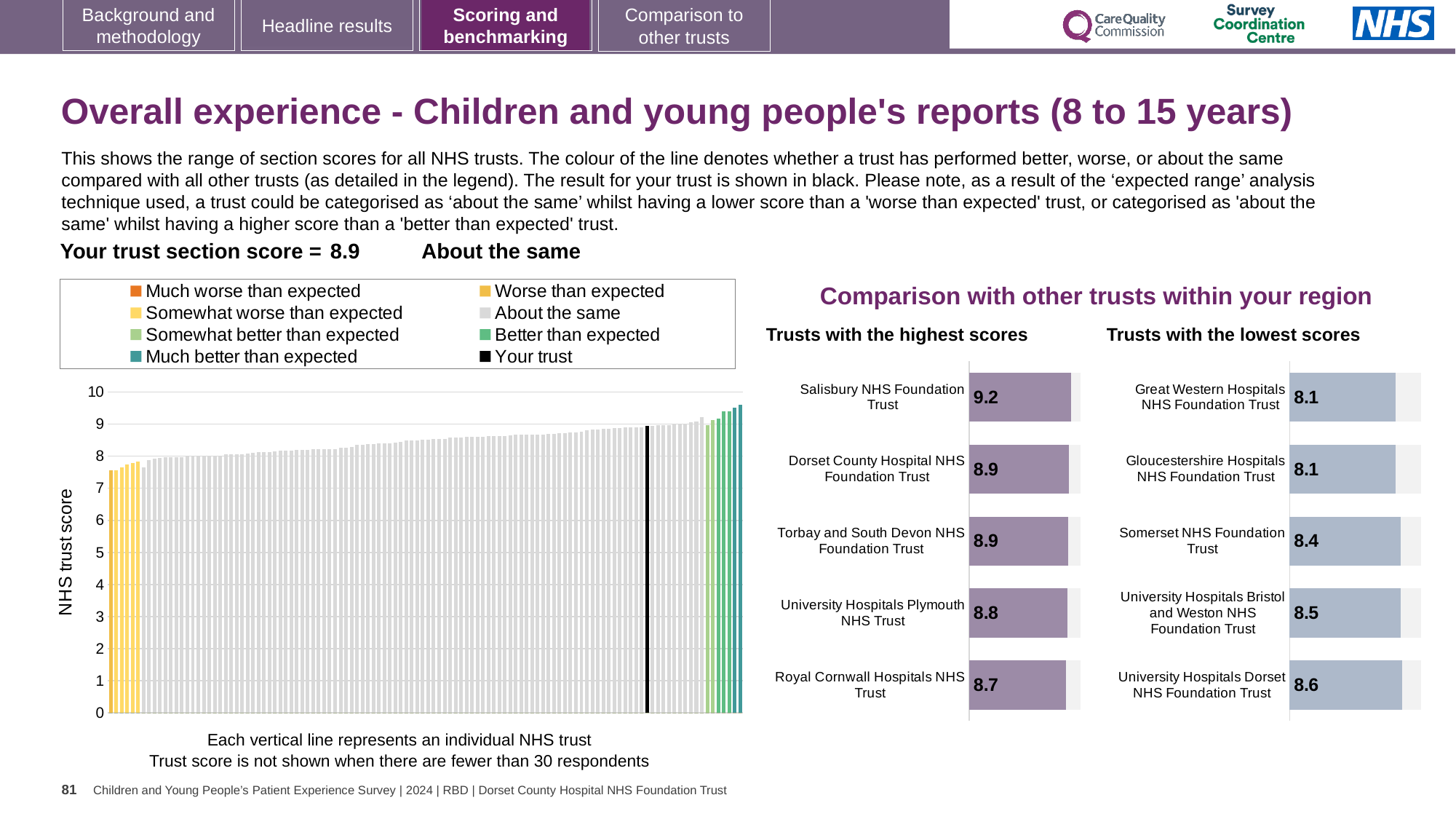
In the 'Trusts with the highest scores' chart, what is the score for Salisbury NHS Foundation Trust? 9.2 What is the y-axis label of the main chart of all NHS trusts? NHS trust score In the 'Trusts with the highest scores' chart, what is the score for Royal Cornwall Hospitals NHS Trust? 8.7 In the 'Trusts with the highest scores' chart, which trust has the lowest score? Royal Cornwall Hospitals NHS Trust What kind of chart is the main chart showing the range of section scores for all NHS trusts? Bar chart In the 'Trusts with the lowest scores' chart, which trust has the highest score? University Hospitals Dorset NHS Foundation Trust How many entries does the legend of the main chart of all NHS trusts list? 8 How many trusts are shown in the 'Trusts with the lowest scores' chart? 5 In the main chart of all NHS trusts, is the value for the black 'Your trust' bar greater or less than 8? greater In the 'Trusts with the lowest scores' chart, which has the larger score: Somerset NHS Foundation Trust or University Hospitals Bristol and Weston NHS Foundation Trust? University Hospitals Bristol and Weston NHS Foundation Trust In the 'Trusts with the lowest scores' chart, what is the score for Somerset NHS Foundation Trust? 8.4 In the 'Trusts with the highest scores' chart, what is the difference between the scores of Salisbury NHS Foundation Trust and Royal Cornwall Hospitals NHS Trust? 0.5